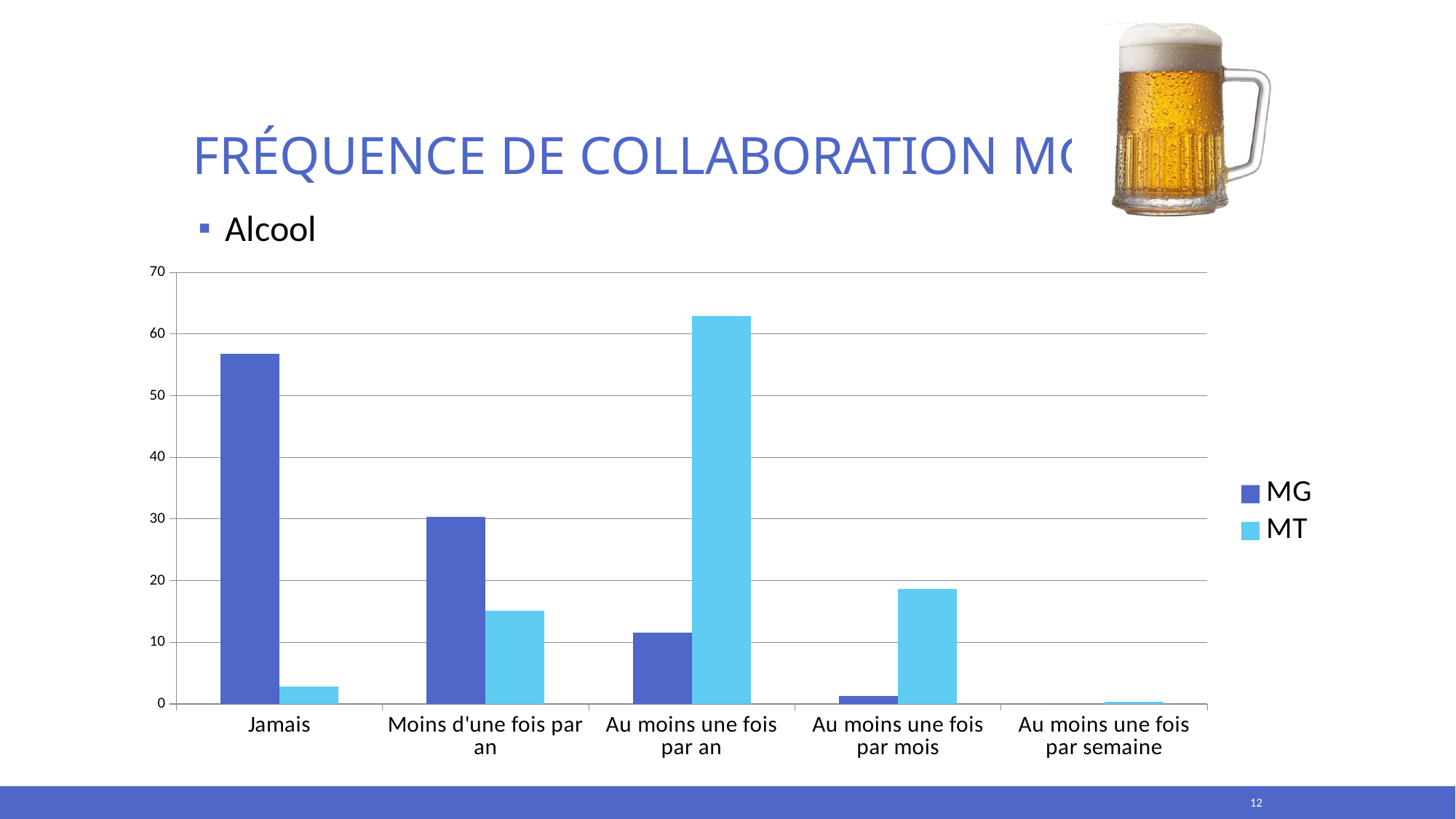
How many categories are shown on the x axis? 5 Is the MT value for Au moins une fois par an greater or less than 60? greater Is the MT value for Moins d'une fois par an greater or less than 20? less What kind of chart is shown on the slide? bar chart Which category has the highest MG value? Jamais Which category has the highest MT value? Au moins une fois par an How many series does the legend list? 2 Which is larger for Au moins une fois par mois, the MG value or the MT value? MT Which is larger for Jamais, the MG value or the MT value? MG Is the MG value for Jamais greater or less than 50? greater What are the two series named in the legend? MG and MT